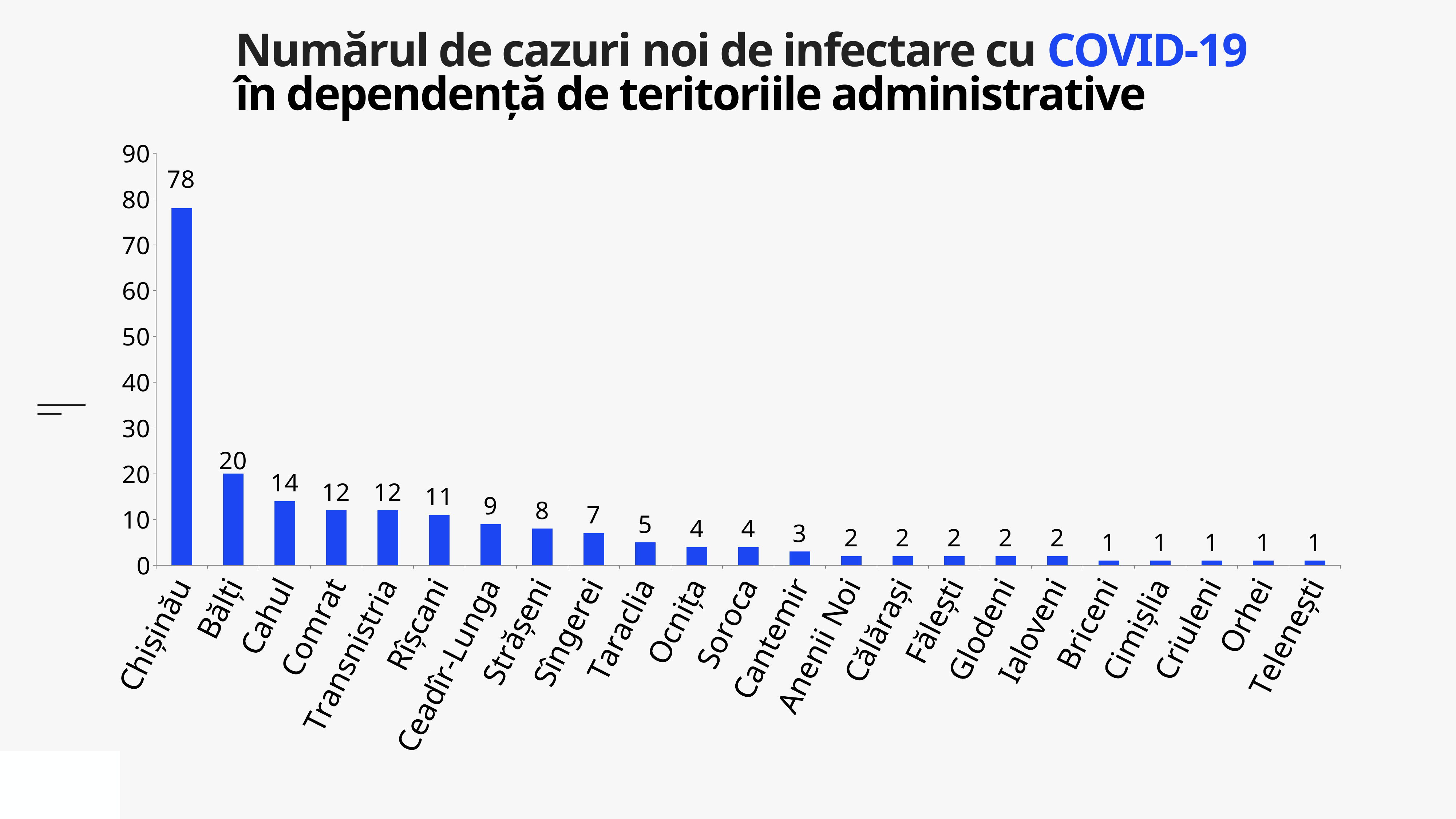
Do the values rise or fall from left to right along the x axis? fall What is the value for Bălți? 20 How many categories are shown on the x axis? 23 Is the value for Chișinău greater or less than 70? greater What is the value for Taraclia? 5 Which is larger, the value for Strășeni or the value for Sîngerei? Strășeni What is the difference between the values for Cahul and Rîșcani? 3 What kind of chart is this? bar chart What is the value for Ceadîr-Lunga? 9 What is the value for Chișinău? 78 Which category has the highest value? Chișinău What is the difference between the values for Chișinău and Bălți? 58